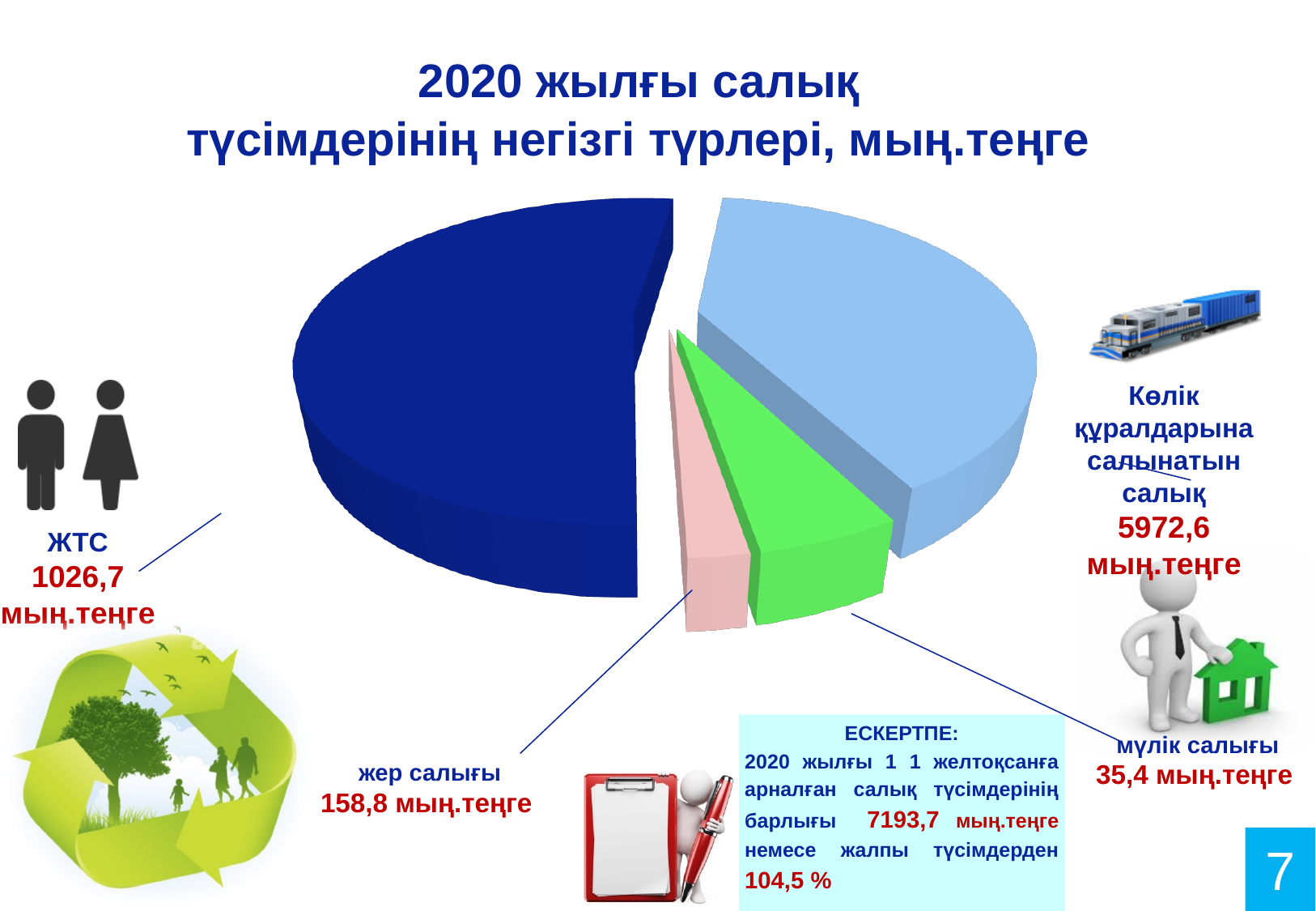
What type of chart is shown on the slide? pie chart How many slices does the pie chart have? 4 What is the value labelled for ЖТС? 1026,7 мың.теңге Which tax type has the highest labelled value? Көлік құралдарына салынатын салық What is the value labelled for жер салығы? 158,8 мың.теңге What is the value labelled for Көлік құралдарына салынатын салық? 5972,6 мың.теңге What is the title of the chart on the slide? 2020 жылғы салық түсімдерінің негізгі түрлері, мың.теңге What is the difference between the labelled values for Көлік құралдарына салынатын салық and ЖТС? 4945,9 мың.теңге Which is larger, the labelled value for ЖТС or for жер салығы? ЖТС What is the value labelled for мүлік салығы? 35,4 мың.теңге Which tax type has the lowest labelled value? мүлік салығы What is the difference between the labelled values for жер салығы and мүлік салығы? 123,4 мың.теңге